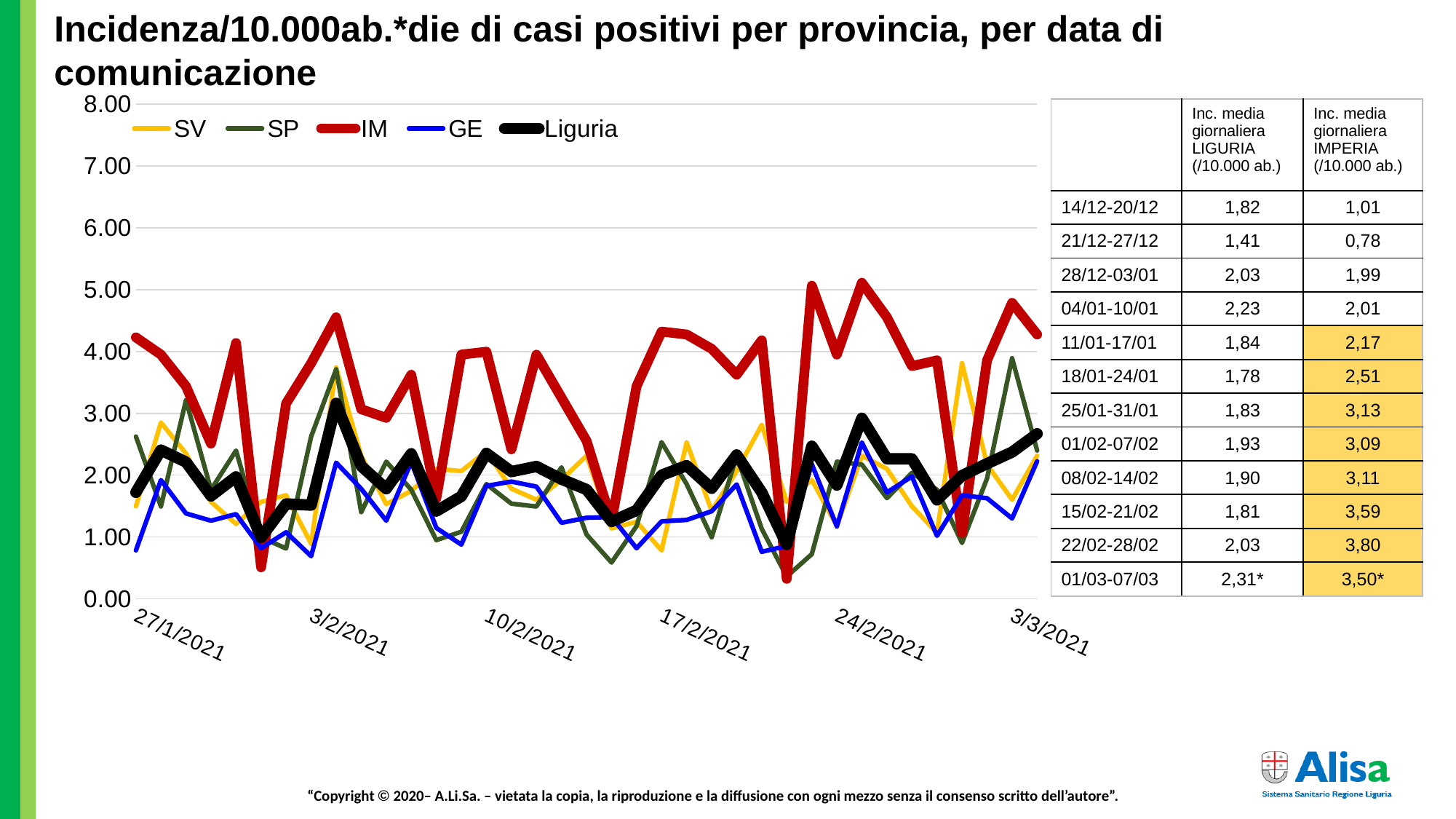
Which series reaches the highest value anywhere on the chart? IM How many series does the chart legend list? 5 Which series is drawn in red in the chart? IM How many date labels are shown on the x axis of the chart? 6 Which series has the lowest value at 27/1/2021? GE Which series is drawn as the thick black line in the chart? Liguria Is the value for GE at 27/1/2021 greater or less than 1.00? less Is the value for Liguria at 3/3/2021 greater or less than 2.00? greater Is the value for IM at 3/3/2021 greater or less than 4.00? greater Which series has the highest value at 3/3/2021? IM At 27/1/2021, which is larger, the value for IM or the value for Liguria? IM What kind of chart is shown on the slide? line chart